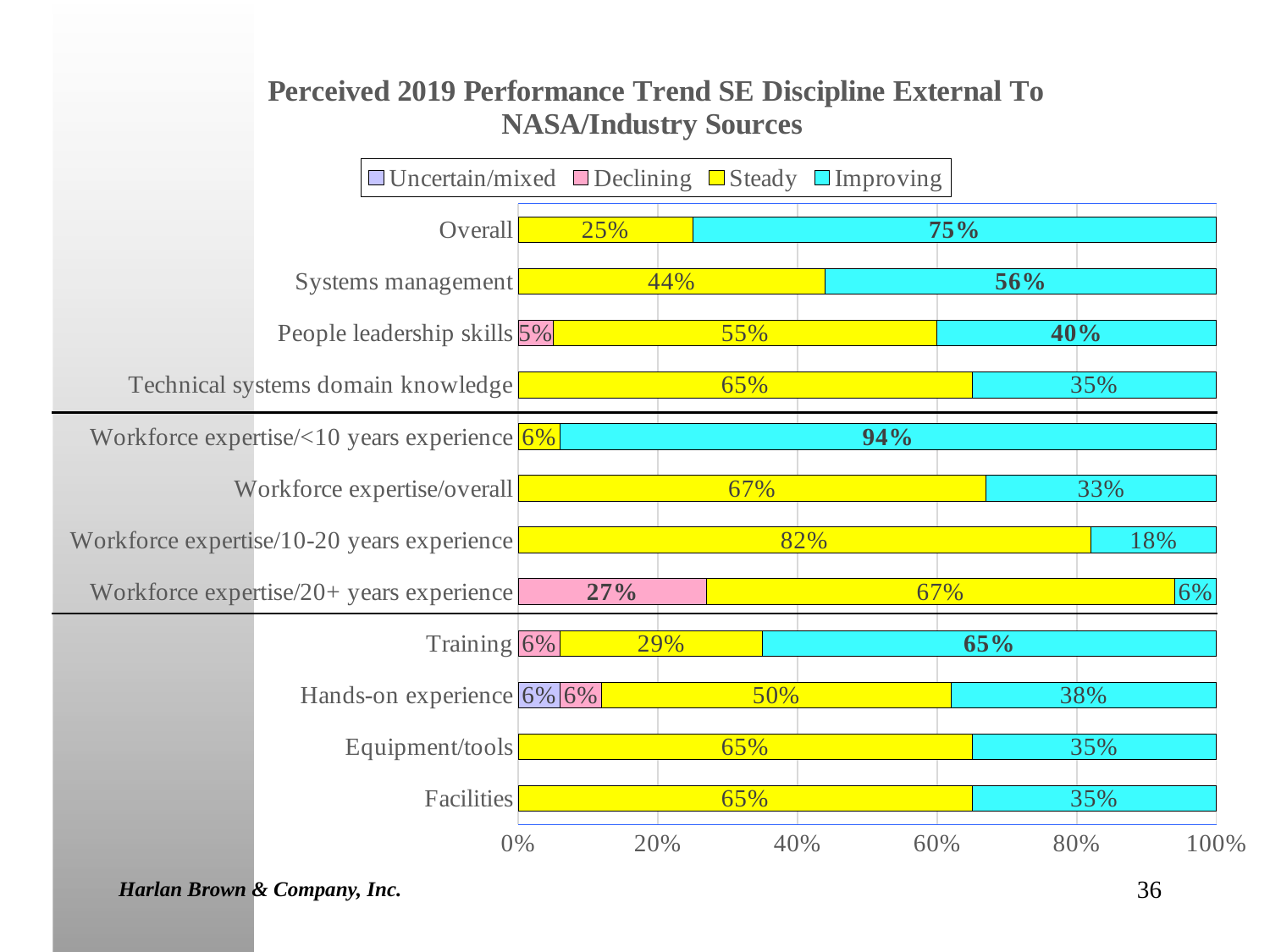
What is the Uncertain/mixed value for Hands-on experience? 6% What is the total of the Steady and Improving segments for People leadership skills? 95% Which is larger, the Improving value for Training or the Improving value for Hands-on experience? Training How many categories are shown on the chart? 12 Which category has the highest Improving value? Workforce expertise/<10 years experience Which category has the lowest Improving value? Workforce expertise/20+ years experience What is the difference between the Steady values for Systems management and Overall? 19% What kind of chart is this? Stacked bar chart What is the Steady value for Workforce expertise/10-20 years experience? 82% What is the Declining value for Workforce expertise/20+ years experience? 27% What is the Improving value for Overall? 75% How many series does the legend list? 4